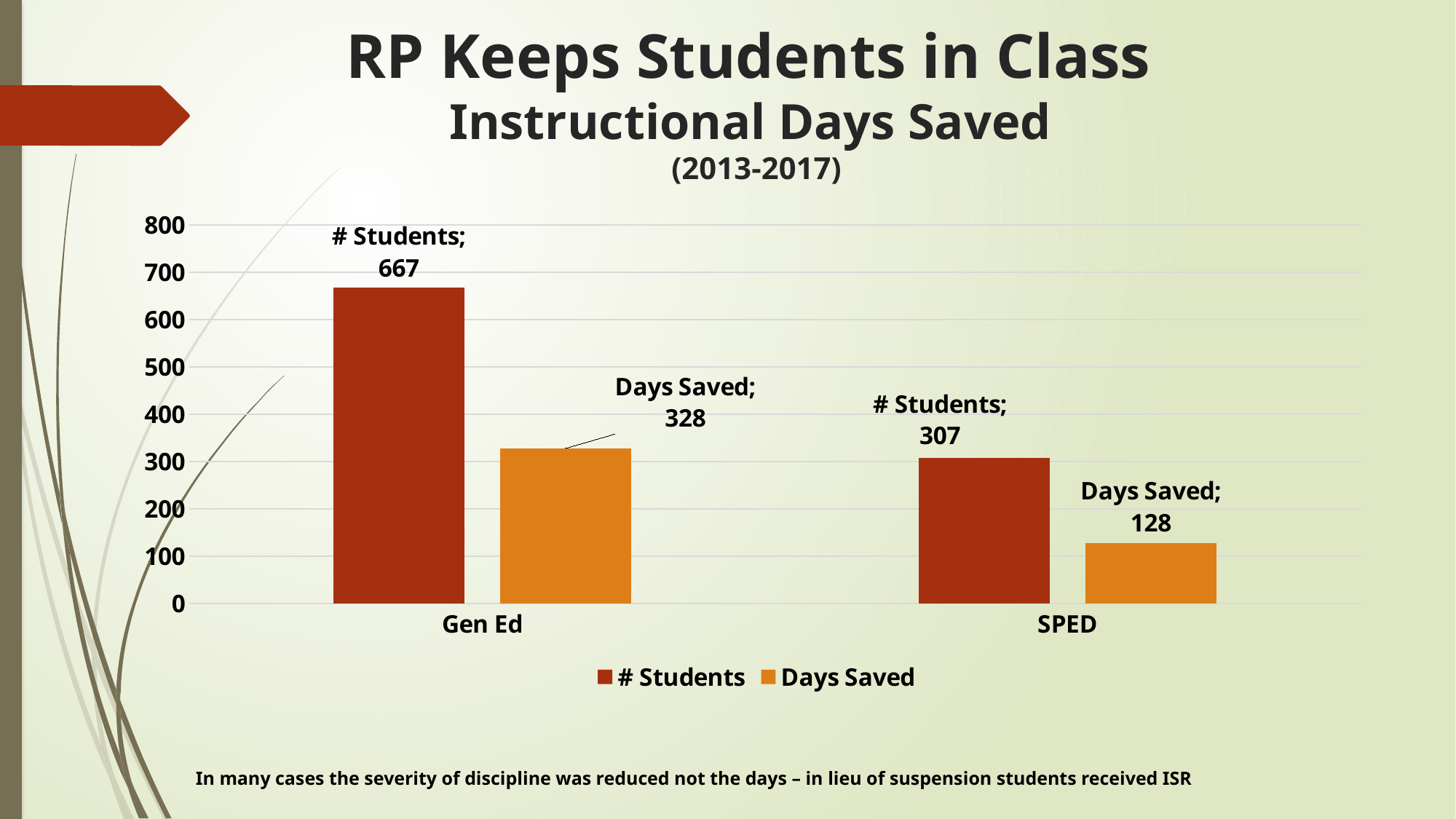
What kind of chart is shown on the slide? Bar chart Which is larger: days saved for Gen Ed or the number of students for SPED? Days saved for Gen Ed How many days were saved for Gen Ed? 328 Which category has the higher number of students? Gen Ed How many series does the legend list? 2 What is the difference between the number of students for Gen Ed and for SPED? 360 What is the number of students for SPED? 307 How many days were saved for SPED? 128 What is the difference between days saved for Gen Ed and days saved for SPED? 200 What is the number of students for Gen Ed? 667 How many categories are shown on the x axis? 2 Which category has the fewest days saved? SPED